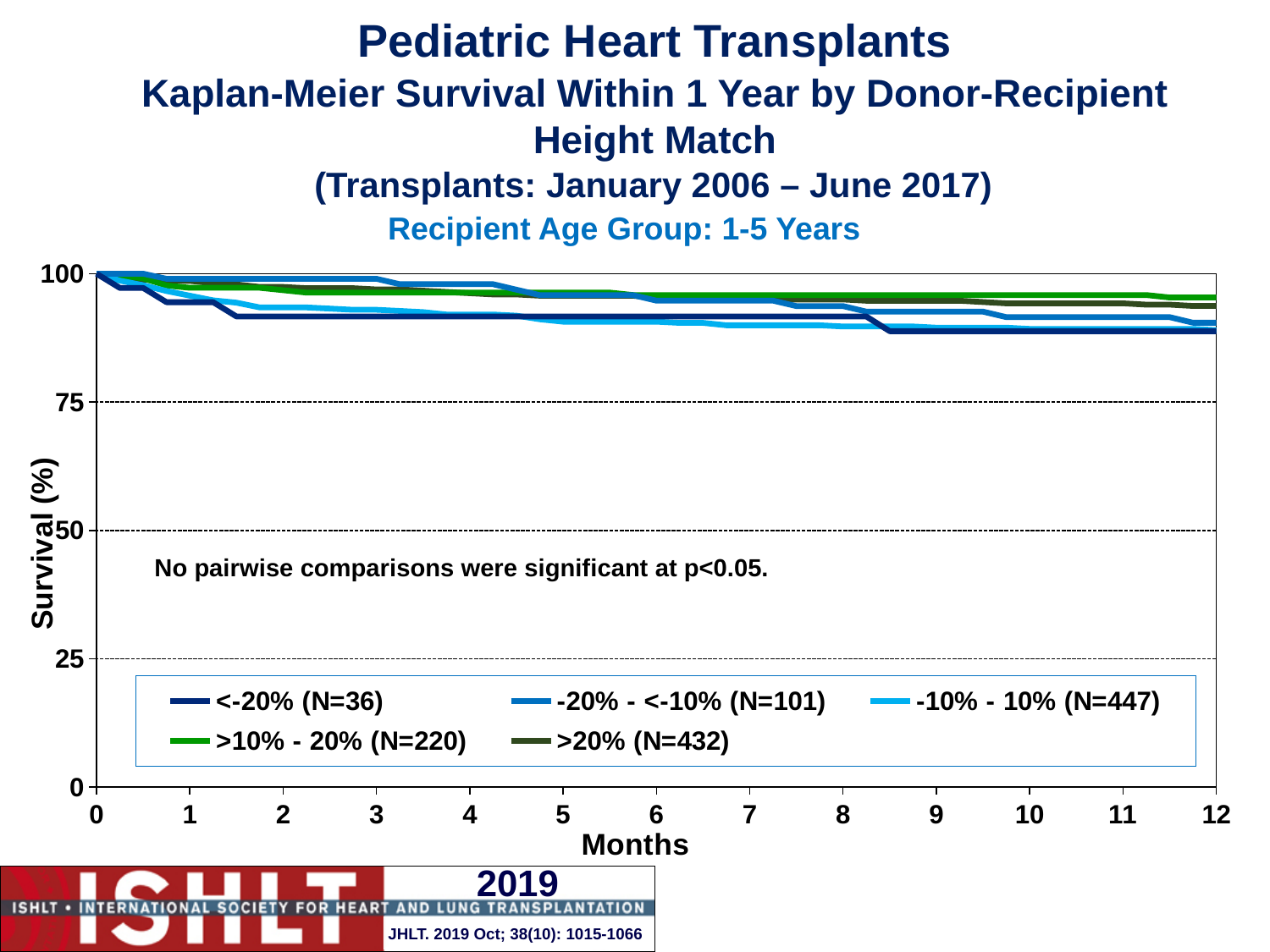
What recipient age group does the chart cover? 1-5 Years What is the N for the -20% - <-10% height match group shown in the legend? 101 What is the N for the >20% height match group shown in the legend? 432 Do the survival curves rise or fall as months increase along the x axis? fall What is the N for the <-20% height match group shown in the legend? 36 Is the survival for the <-20% (N=36) group at 12 months greater or less than 75? greater What is the maximum value shown on the x axis (Months)? 12 Is the survival for the -10% - 10% (N=447) group at 6 months greater or less than 75? greater How many series does the legend list? 5 What kind of chart is shown on the slide? line chart What is the N for the -10% - 10% height match group shown in the legend? 447